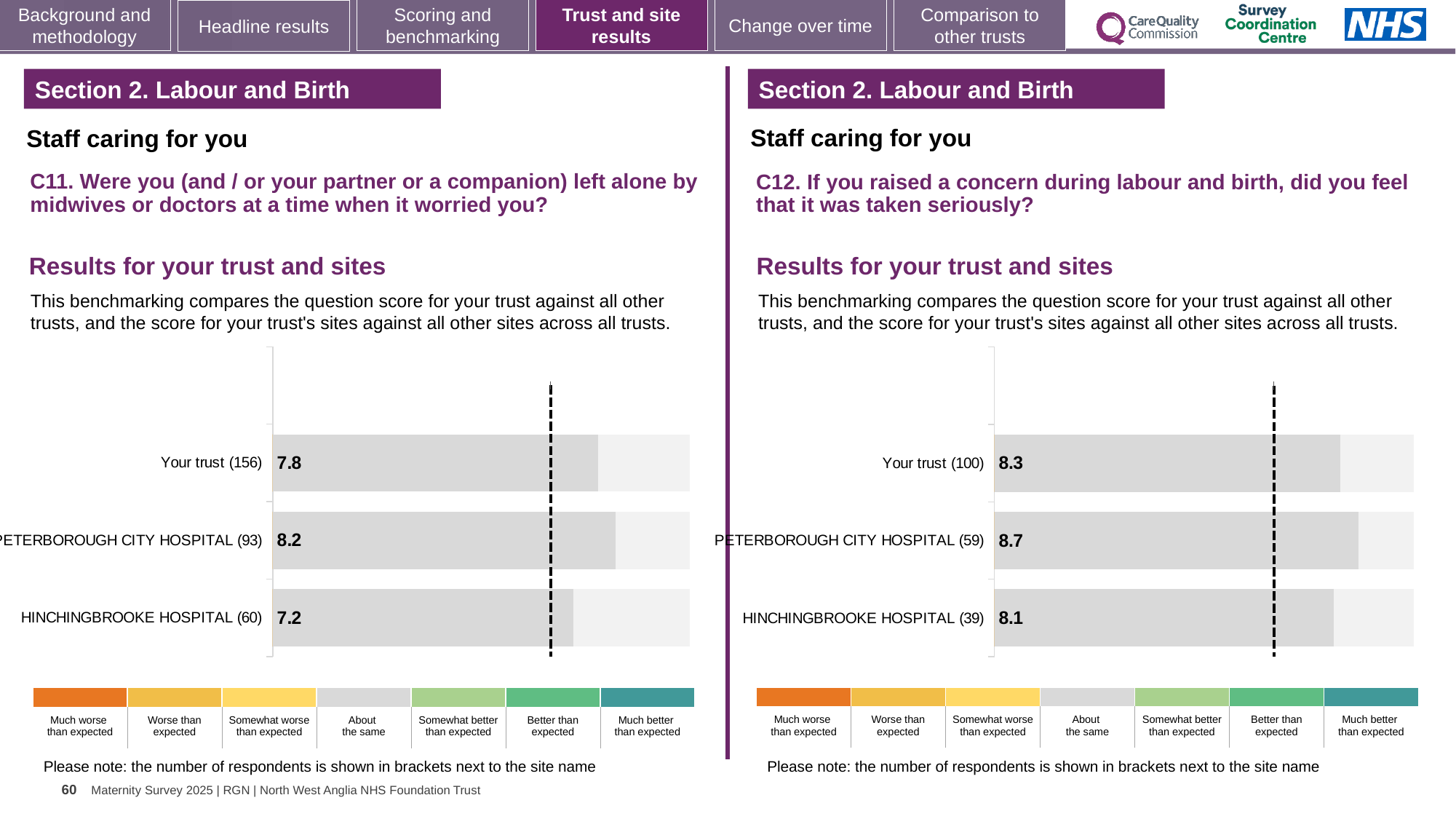
On the C12 chart (right), which site or trust has the lowest score? HINCHINGBROOKE HOSPITAL On the C11 chart (left), what is the score for Your trust? 7.8 On the C12 chart (right), is the score for Your trust larger or smaller than the score for HINCHINGBROOKE HOSPITAL? larger On the C11 chart (left), what is the difference between the scores for PETERBOROUGH CITY HOSPITAL and HINCHINGBROOKE HOSPITAL? 1.0 On the C12 chart (right), what is the score for PETERBOROUGH CITY HOSPITAL? 8.7 On the C12 chart (right), how many respondents are shown in brackets for HINCHINGBROOKE HOSPITAL? 39 On the C11 chart (left), which site or trust has the highest score? PETERBOROUGH CITY HOSPITAL How many bars are plotted on the C11 chart (left)? 3 On the C11 chart (left), what is the score for HINCHINGBROOKE HOSPITAL? 7.2 On the C11 chart (left), how many respondents are shown in brackets for Your trust? 156 On the C12 chart (right), what is the difference between the scores for PETERBOROUGH CITY HOSPITAL and Your trust? 0.4 What type of chart is used on the C12 chart (right)? bar chart